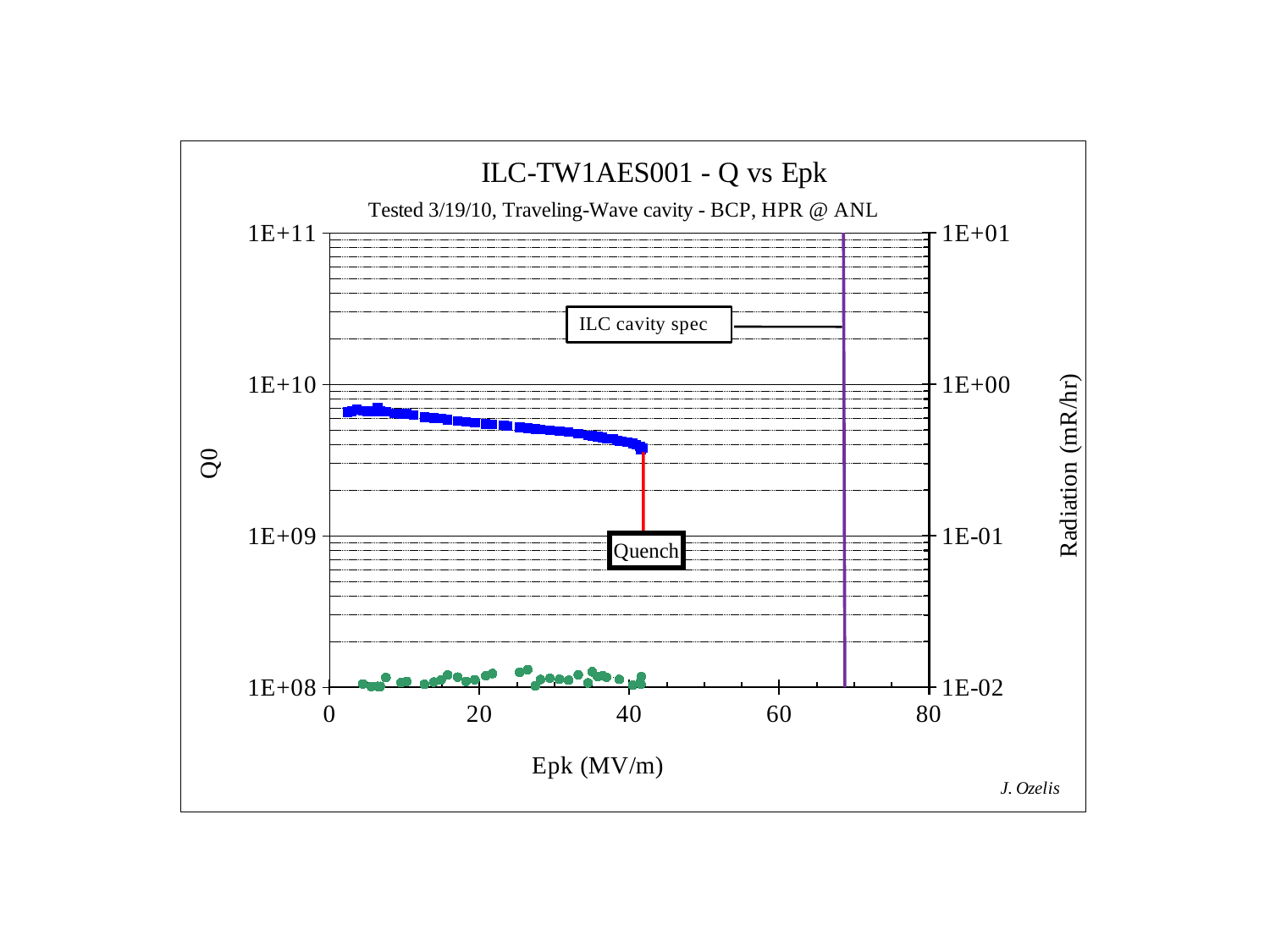
What is the title of the chart? ILC-TW1AES001 - Q vs Epk Is the Q0 value at Epk = 20 MV/m greater or less than 1E+10? less Is the Q0 value at Epk = 40 MV/m greater or less than 1E+09? greater Is the radiation value (green dots) at Epk = 30 MV/m greater or less than 1E-01 mR/hr? less What kind of chart is shown on the slide? scatter chart Is the Q0 value at Epk = 10 MV/m larger or smaller than the Q0 value at Epk = 40 MV/m? larger What label is attached to the vertical purple line near Epk 68 MV/m? ILC cavity spec Does the Q0 value (blue squares) rise or fall as Epk increases from 0 to 40 MV/m? fall